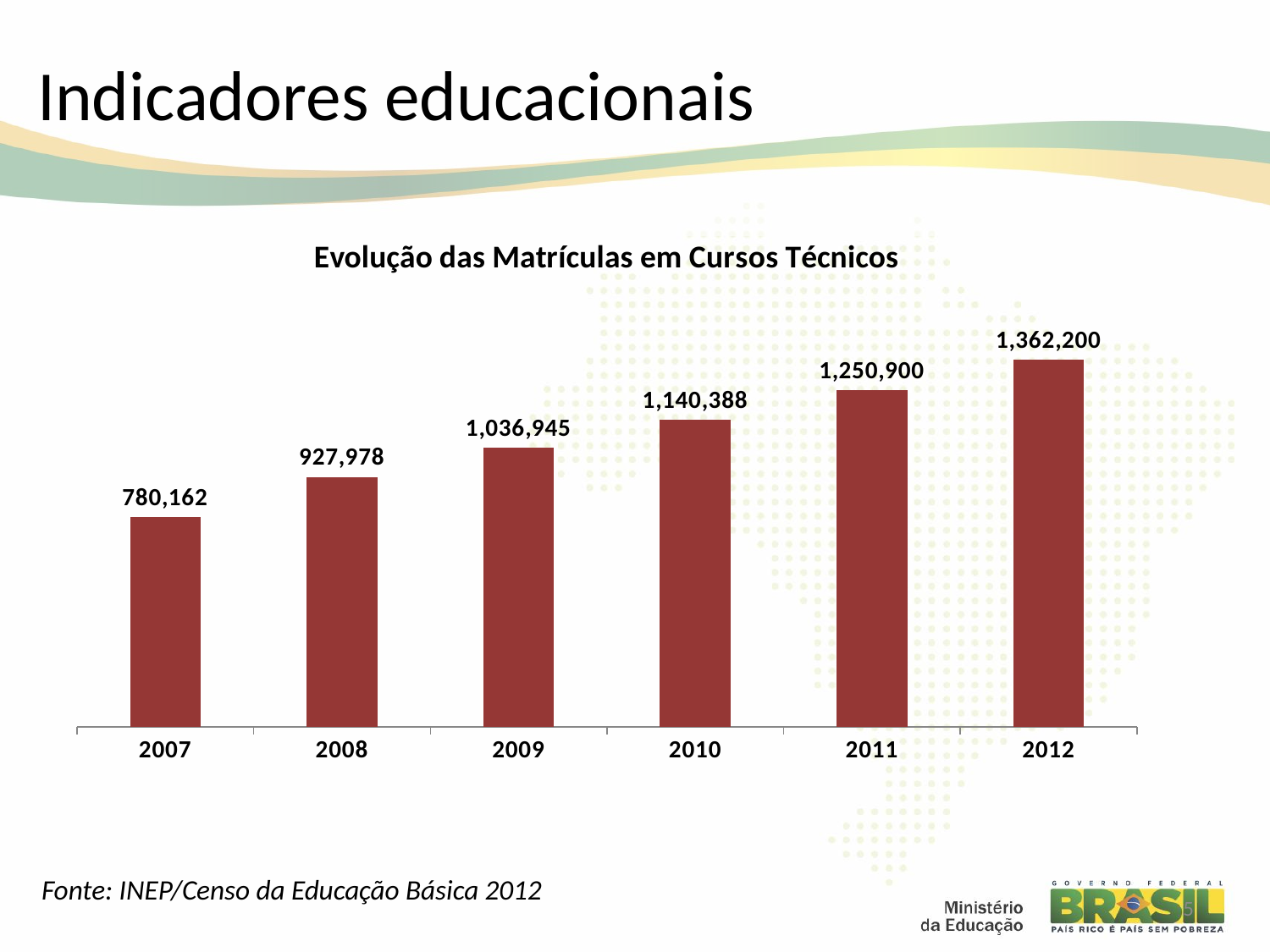
What is the value for 2007? 780,162 Do the values rise or fall from 2007 to 2012? Rise What kind of chart is shown on the slide? Bar chart How many years are shown on the x axis? 6 Which year has the highest value? 2012 Which year has the lowest value? 2007 What is the difference between the values for 2012 and 2007? 582,038 What is the difference between the values for 2012 and 2011? 111,300 What is the difference between the values for 2008 and 2007? 147,816 Which is larger, the value for 2009 or the value for 2011? 2011 What is the value for 2012? 1,362,200 What is the value for 2010? 1,140,388